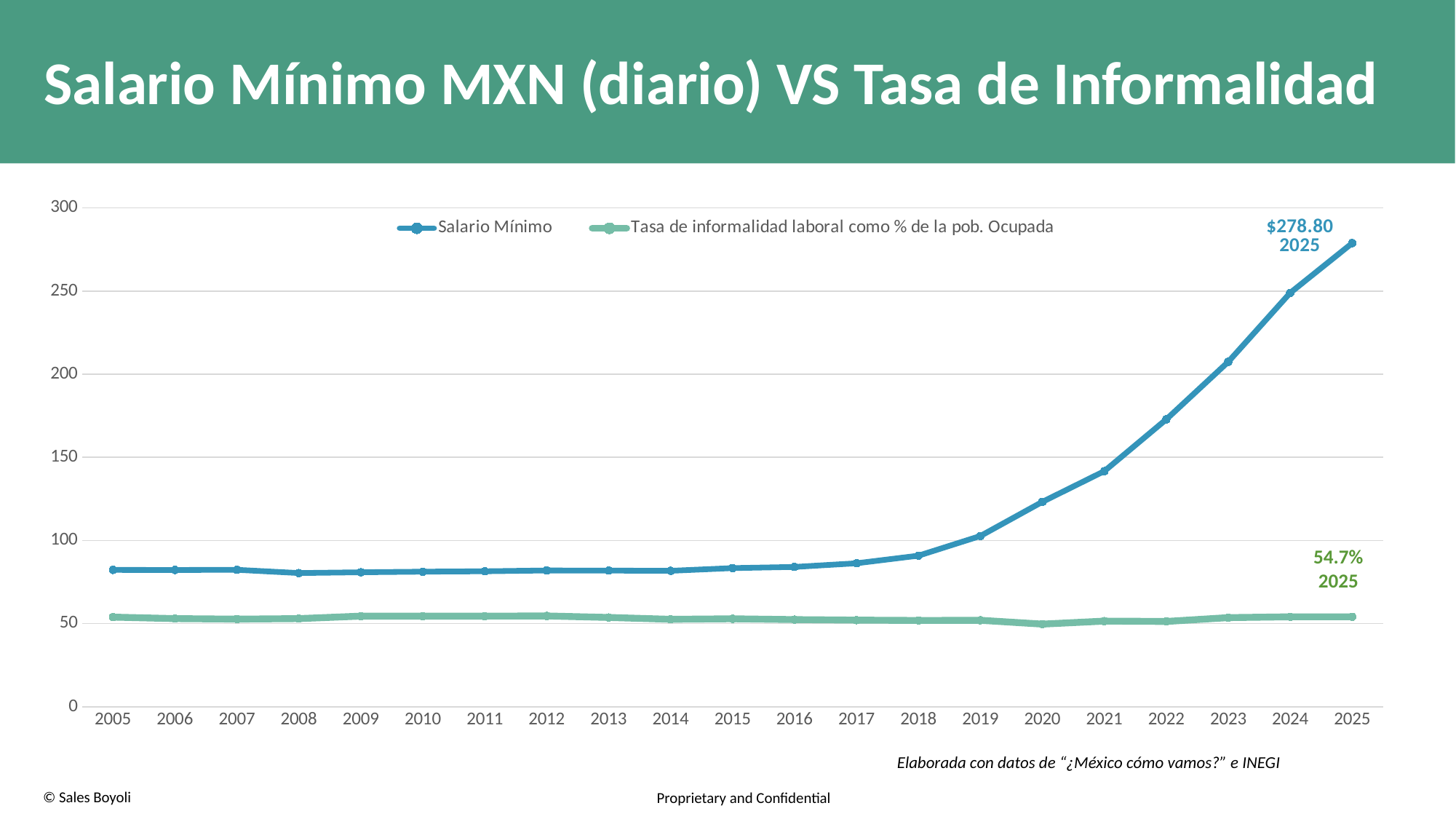
What is the title of the chart? Salario Mínimo MXN (diario) VS Tasa de Informalidad How many series does the legend list? 2 How many years are shown on the x axis? 21 Which series has the larger value in 2025, Salario Mínimo or Tasa de informalidad laboral? Salario Mínimo What type of chart is shown on the slide? line chart Is the Salario Mínimo value for 2023 greater or less than 200? greater What is the value of Tasa de informalidad laboral como % de la pob. Ocupada in 2025? 54.7% What is the value of Salario Mínimo in 2025? $278.80 Is the Salario Mínimo value for 2021 greater or less than 150? less Does the Salario Mínimo series rise or fall between 2018 and 2025? rise In which year is the Salario Mínimo series highest? 2025